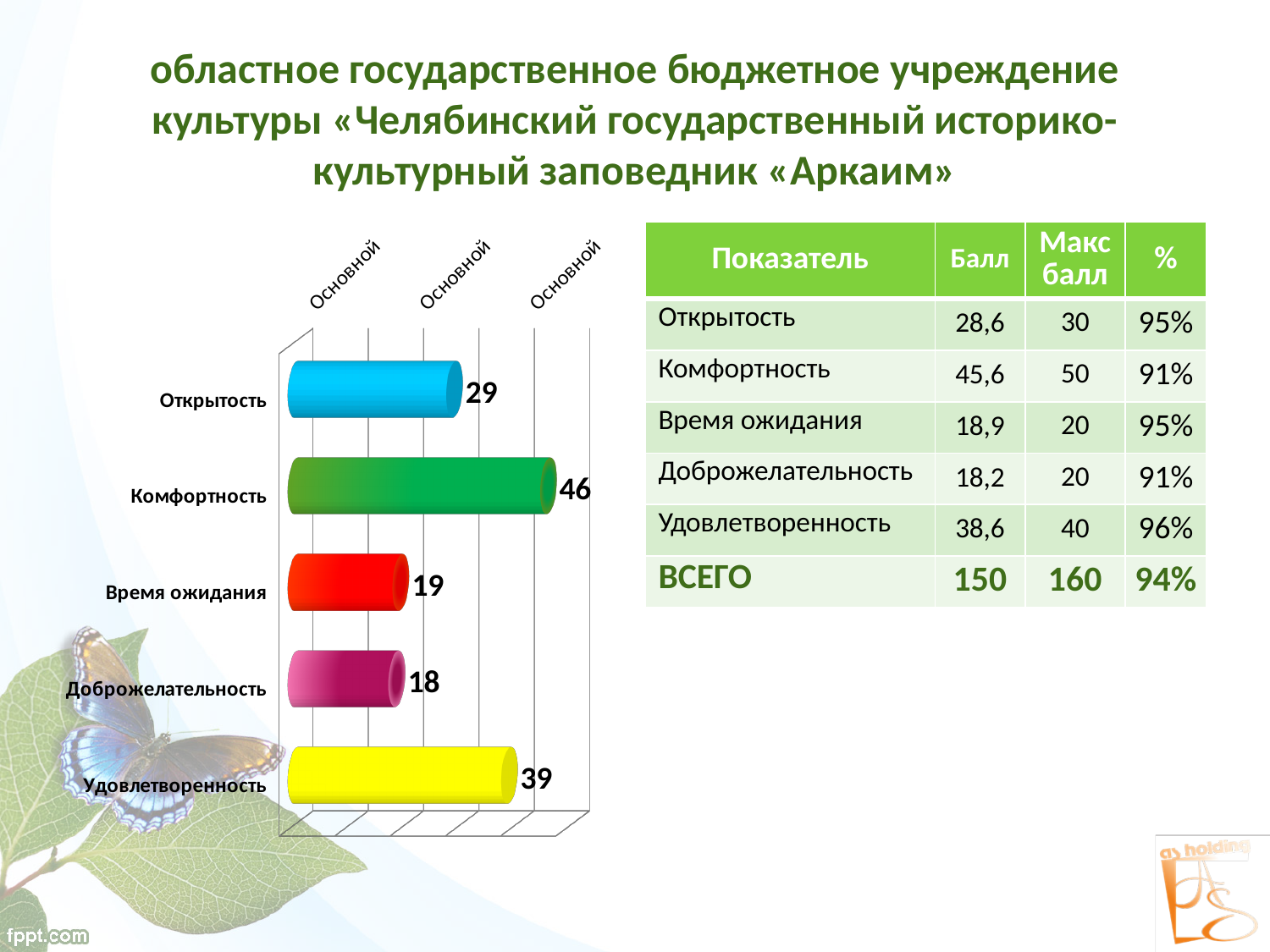
What is the difference between the values for Комфортность and Удовлетворенность in the bar chart? 7 What is the difference between the values for Открытость and Время ожидания in the bar chart? 10 What colour is the bar for Время ожидания in the chart? Red How many categories are shown in the bar chart? 5 What value does the bar chart show for Комфортность? 46 Which category has the lowest value in the bar chart? Доброжелательность What value does the bar chart show for Доброжелательность? 18 What value does the bar chart show for Открытость? 29 Which category has the highest value in the bar chart? Комфортность In the bar chart, which is larger: the value for Открытость or the value for Удовлетворенность? Удовлетворенность What value does the bar chart show for Удовлетворенность? 39 What kind of chart is shown on the slide? Bar chart